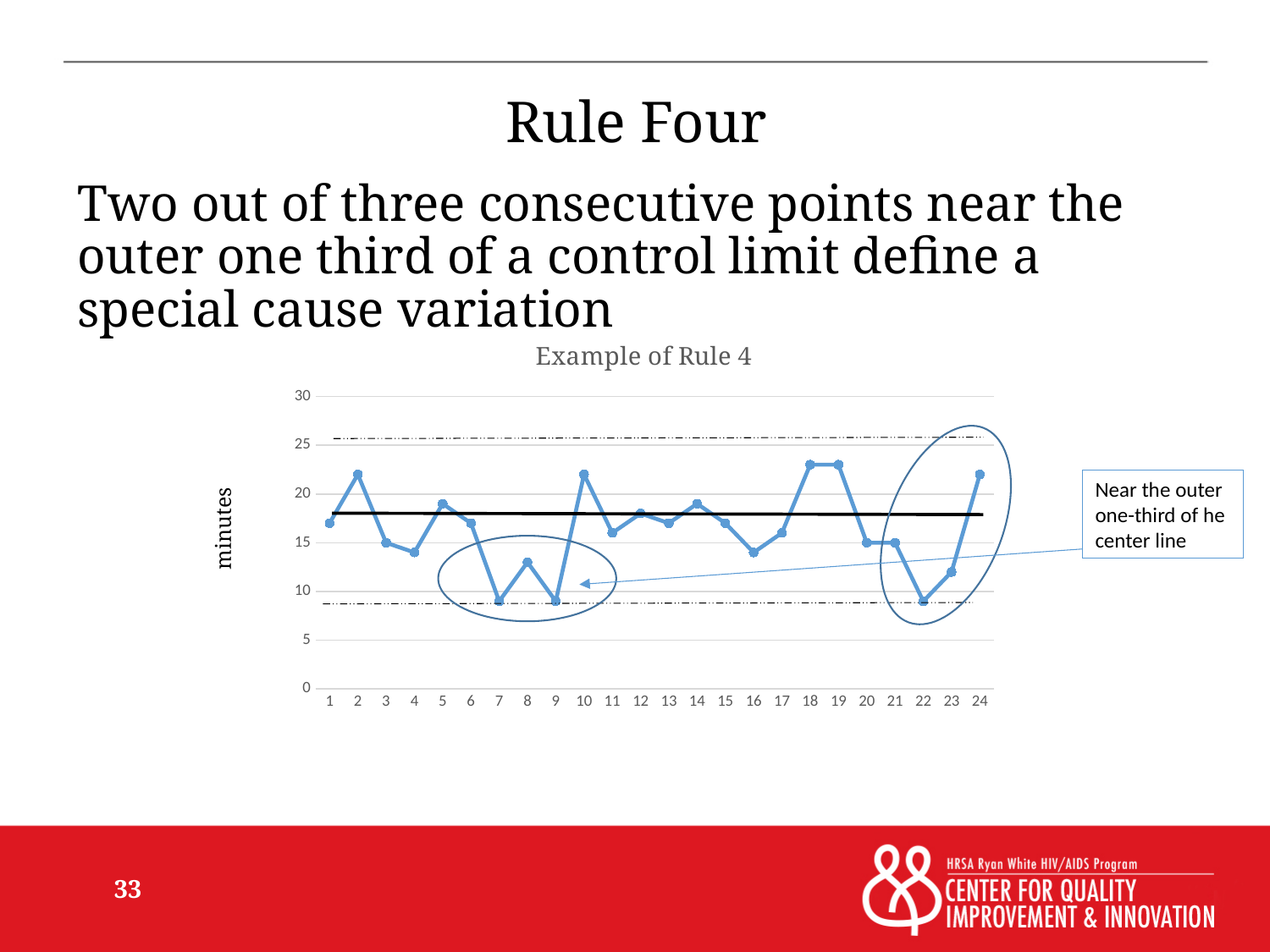
Is the value at point 7 greater or less than 15? less What type of chart is shown on the slide? line chart Is the value at point 18 greater or less than 20? greater Is the value at point 10 greater or less than 20? greater What is the title of the chart? Example of Rule 4 Which has the larger value, point 2 or point 7? point 2 What is the label on the vertical axis of the chart? minutes How many data points are plotted along the x axis of the chart? 24 Which has the larger value, point 18 or point 20? point 18